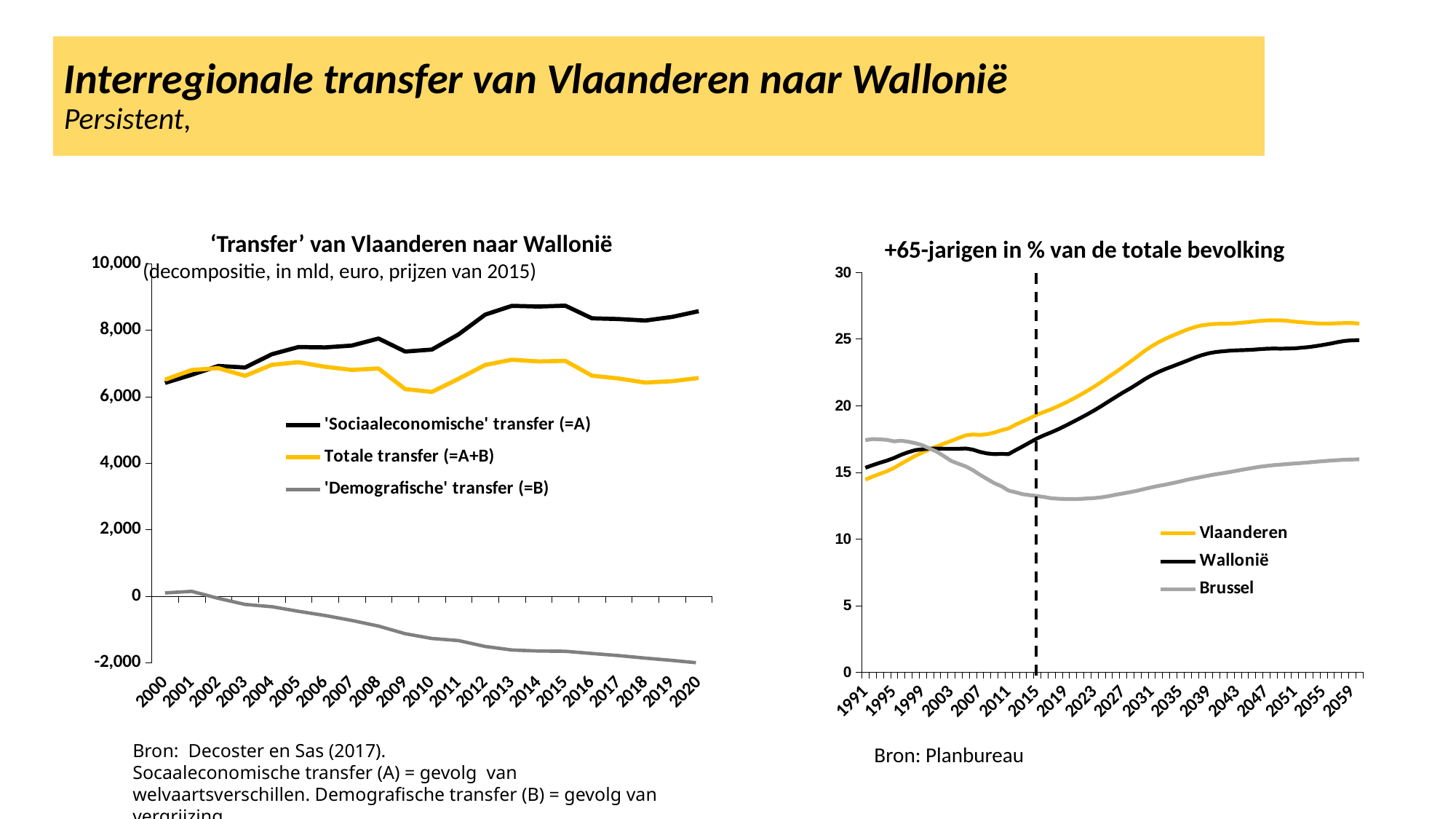
In the right chart (+65-jarigen in % van de totale bevolking), does the Vlaanderen line rise or fall from 1991 to 2059? Rise In the right chart (+65-jarigen in % van de totale bevolking), which region has the highest value in 2059? Vlaanderen In the left chart (‘Transfer’ van Vlaanderen naar Wallonië), which is larger in 2020: the 'Sociaaleconomische' transfer (=A) or the Totale transfer (=A+B)? 'Sociaaleconomische' transfer (=A) In the left chart (‘Transfer’ van Vlaanderen naar Wallonië), does the 'Demografische' transfer (=B) rise or fall from 2000 to 2020? Fall What kind of chart is the left chart titled ‘Transfer’ van Vlaanderen naar Wallonië? Line chart How many series does the legend of the left chart (‘Transfer’ van Vlaanderen naar Wallonië) list? 3 In the left chart (‘Transfer’ van Vlaanderen naar Wallonië), which series has the lowest value in 2020? 'Demografische' transfer (=B) How many series does the legend of the right chart (+65-jarigen in % van de totale bevolking) list? 3 What is the title of the right chart? +65-jarigen in % van de totale bevolking How many years are labelled on the x axis of the left chart (‘Transfer’ van Vlaanderen naar Wallonië)? 21 In the right chart (+65-jarigen in % van de totale bevolking), is the value for Brussel in 2059 greater or less than 20? less In the left chart (‘Transfer’ van Vlaanderen naar Wallonië), is the value of the 'Sociaaleconomische' transfer (=A) in 2013 greater or less than 8,000? greater